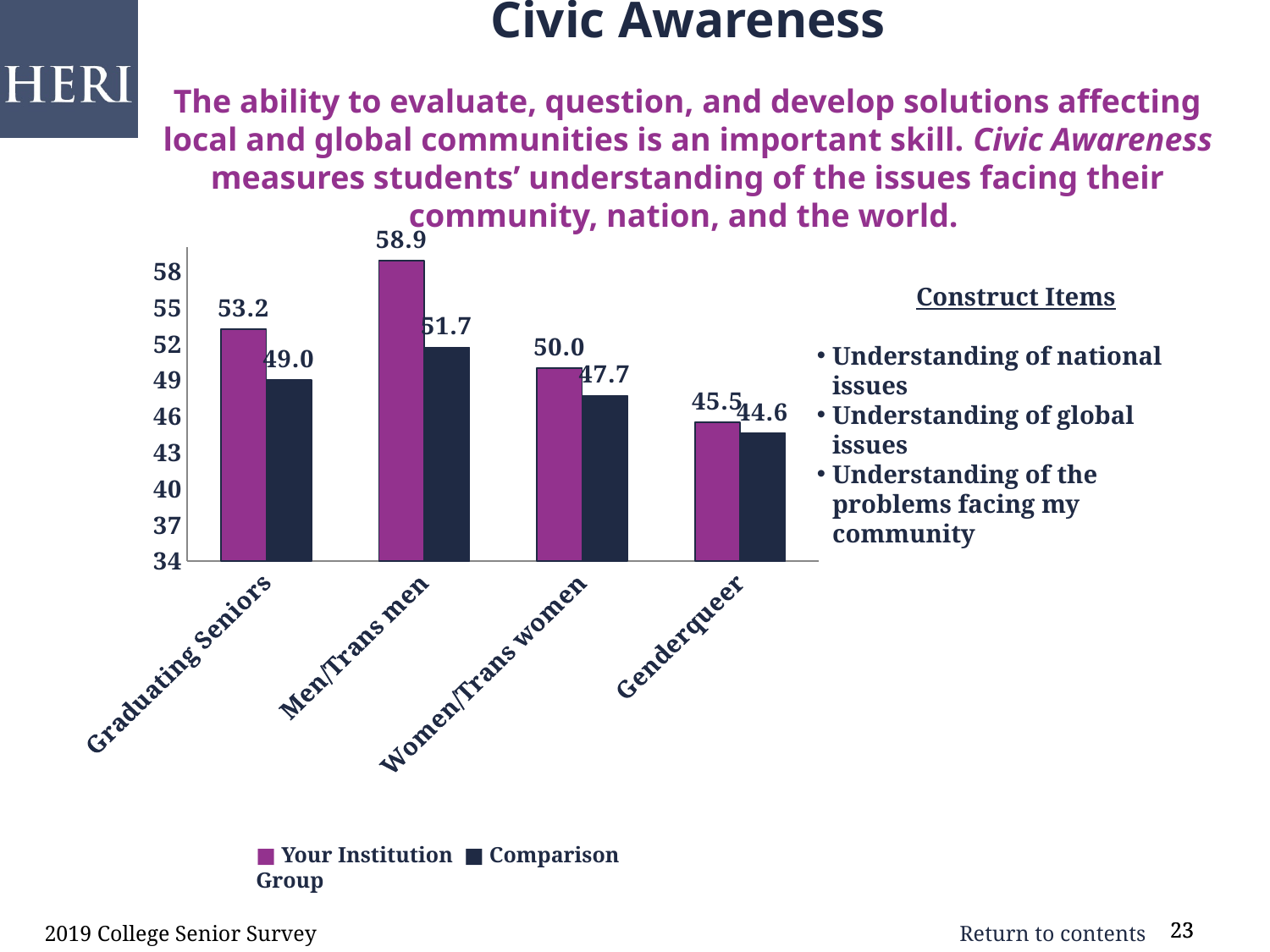
Which series is shown in purple in the legend? Your Institution What is the Your Institution value for Genderqueer? 45.5 How many series does the legend list? 2 What is the Your Institution value for Men/Trans men? 58.9 What is the difference between the Your Institution and Comparison Group values for Men/Trans men? 7.2 Which category has the lowest Comparison Group value? Genderqueer What is the Comparison Group value for Graduating Seniors? 49.0 Which category has the highest Your Institution value? Men/Trans men Which is larger for Graduating Seniors: the Your Institution value or the Comparison Group value? Your Institution How many categories are shown on the x axis? 4 What is the Comparison Group value for Women/Trans women? 47.7 What kind of chart is shown on the slide? Bar chart